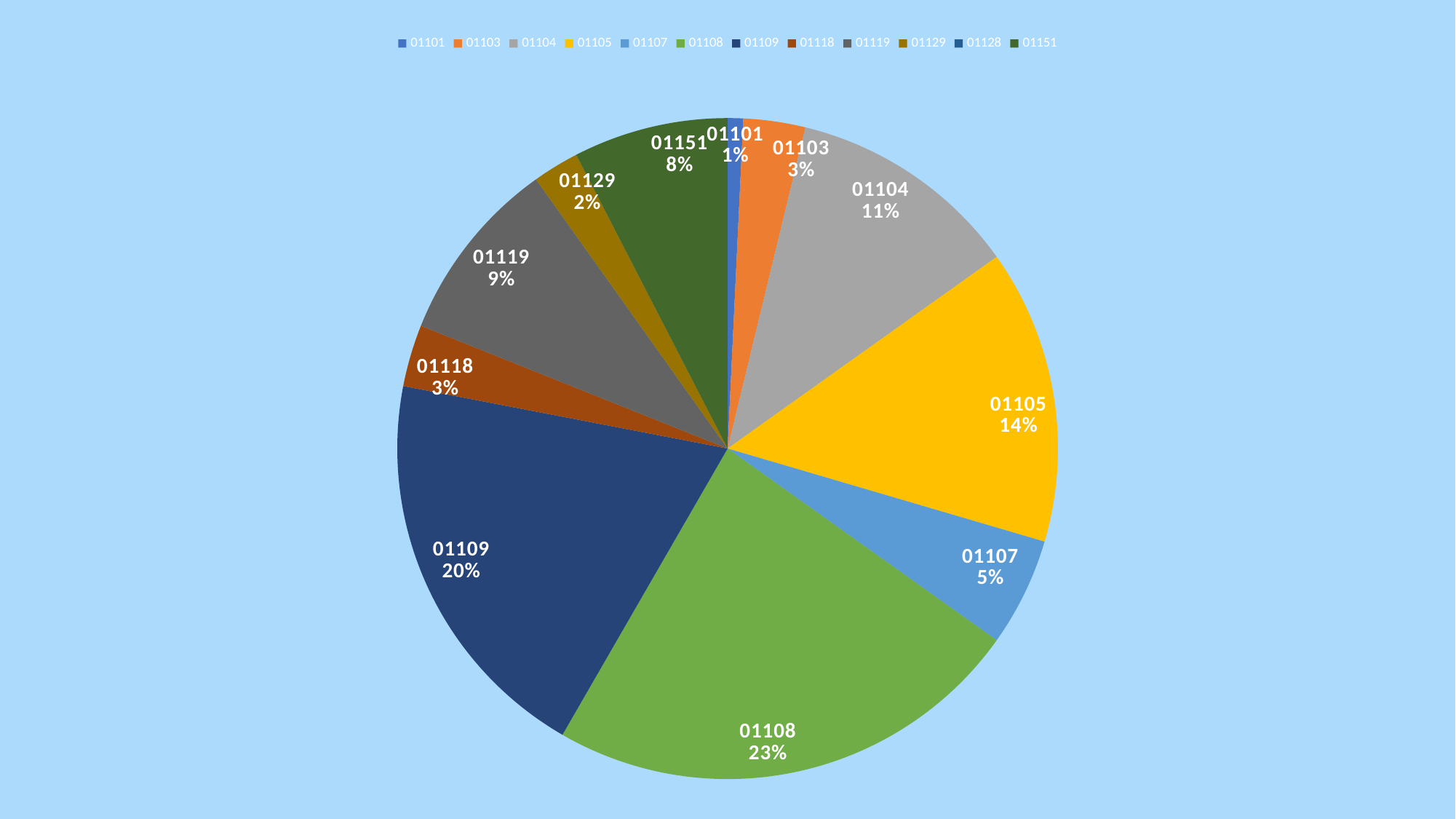
What percentage share does slice 01108 have in the pie chart? 23% What percentage share does slice 01119 have in the pie chart? 9% Which slice has the smallest share of the pie chart? 01101 Which slice has a larger share, 01104 or 01105? 01105 How many entries does the legend of the pie chart list? 12 What is the difference in percentage points between the shares of 01108 and 01109? 3 What percentage share does slice 01105 have in the pie chart? 14% Which slice has the largest share of the pie chart? 01108 What type of chart is shown on the slide? Pie chart What colour is the slice for 01105 in the pie chart? Yellow Which slice has a larger share, 01151 or 01107? 01151 How many labeled slices are visible in the pie chart? 11